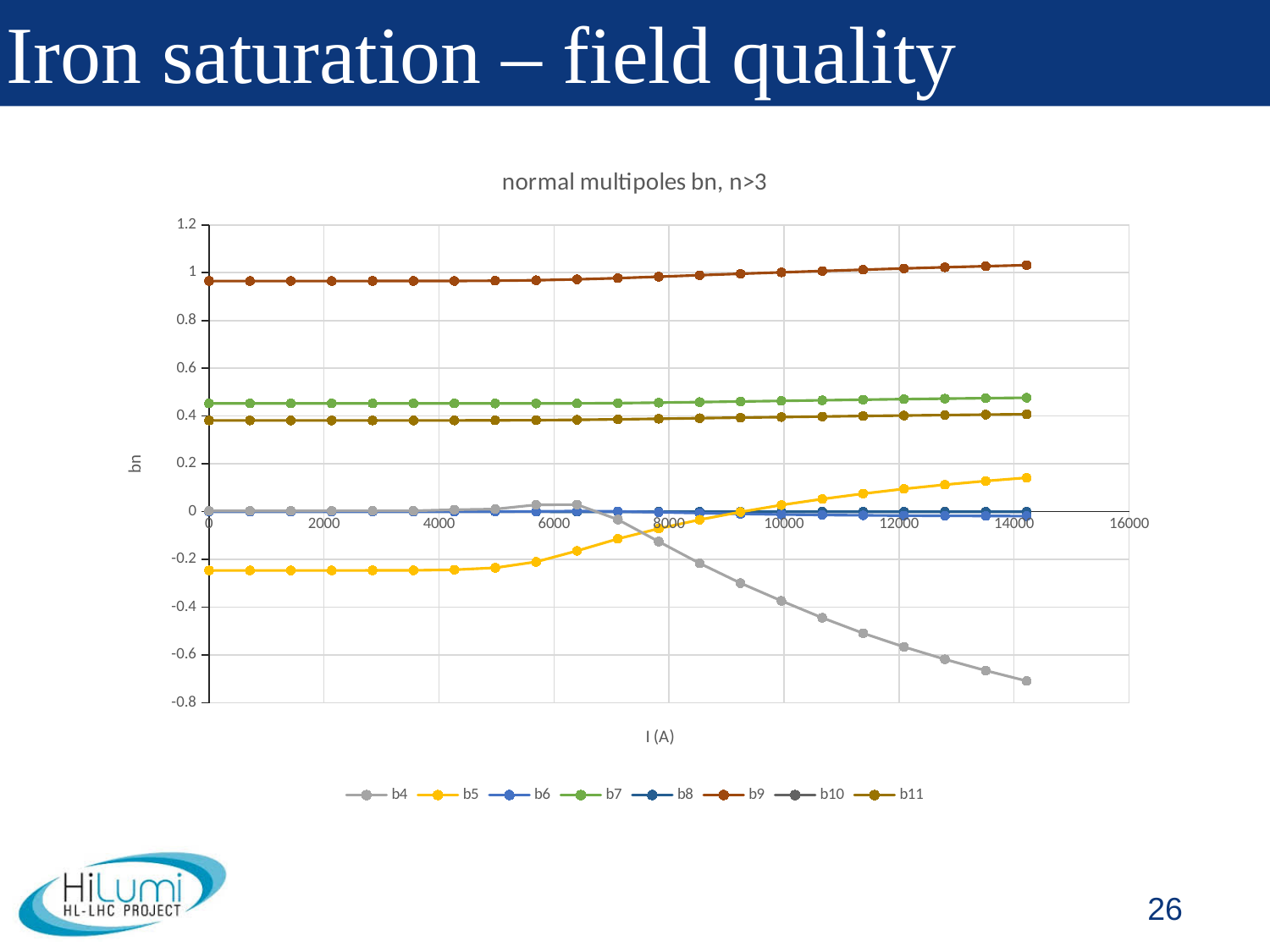
Does the b4 series rise or fall as the current increases beyond about 6000 A? fall At 0 A, which series has the larger value, b9 or b7? b9 Is the value of b9 at 0 A greater or less than 0.8? greater What is the title of the chart? normal multipoles bn, n>3 What kind of chart is shown on the slide? line chart Is the value of b5 at 0 A greater or less than -0.2? less What is the label of the x axis? I (A) Which series has the lowest value at the highest current plotted (around 14000 A)? b4 Does the b5 series rise or fall as the current increases beyond about 6000 A? rise Which series has the highest values across the whole current range? b9 How many series does the legend list? 8 Is the value of b4 at about 14000 A greater or less than -0.6? less